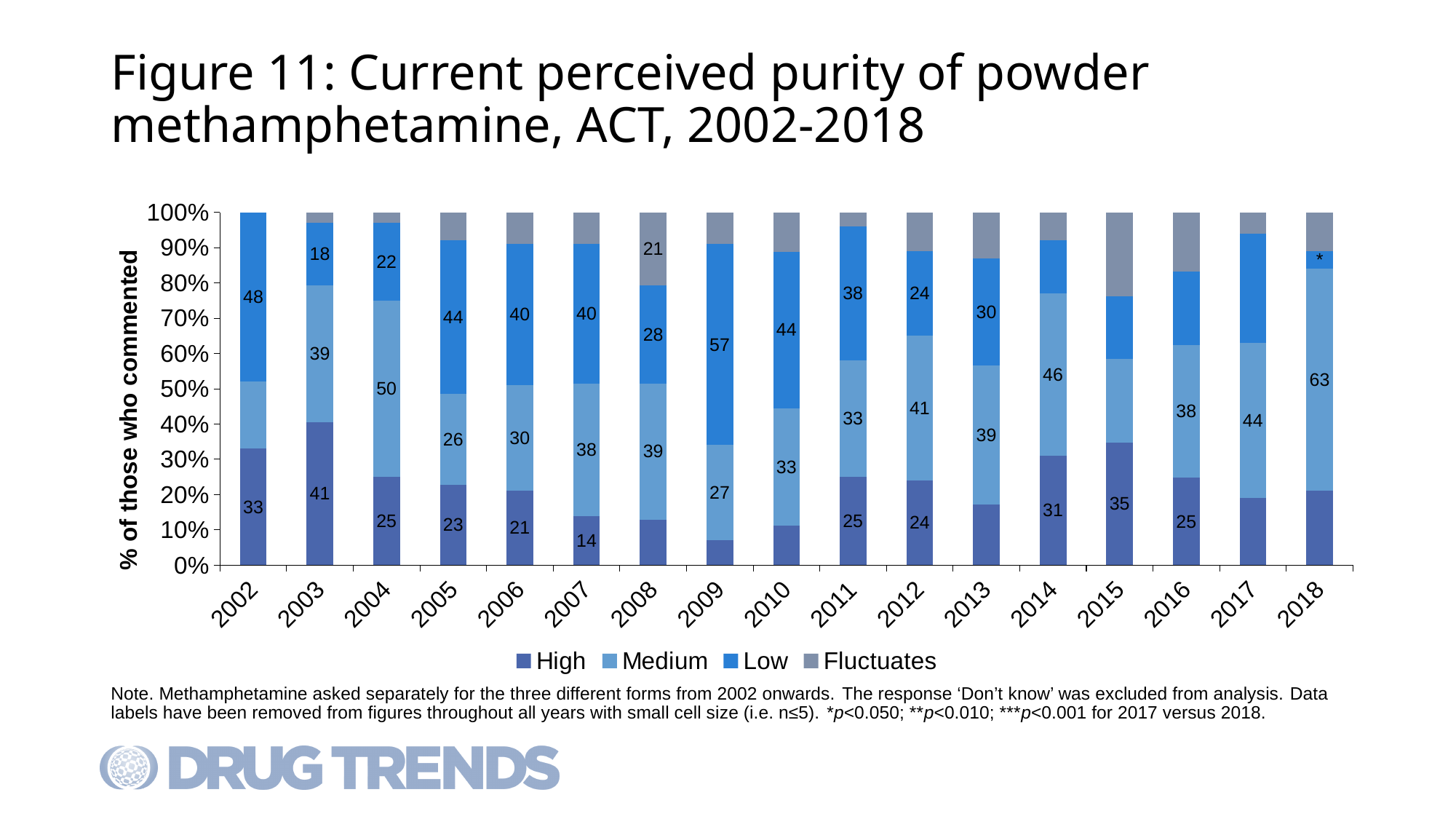
In 2004, what is the difference between the Medium and High values? 25 In which year is the Medium value the largest? 2018 What percentage of respondents rated the purity as Low in 2009? 57 What is the High value shown for 2003? 41 How many series does the legend list? 4 In 2002, how much larger is the Low value than the High value? 15 Is the High segment for 2009 greater or less than 10%? less What is the Medium value for 2018? 63 How many years are shown on the x axis? 17 In which year is the labelled High value the largest? 2003 Which year has the larger Low value, 2009 or 2010? 2009 What is the Fluctuates value labelled for 2008? 21